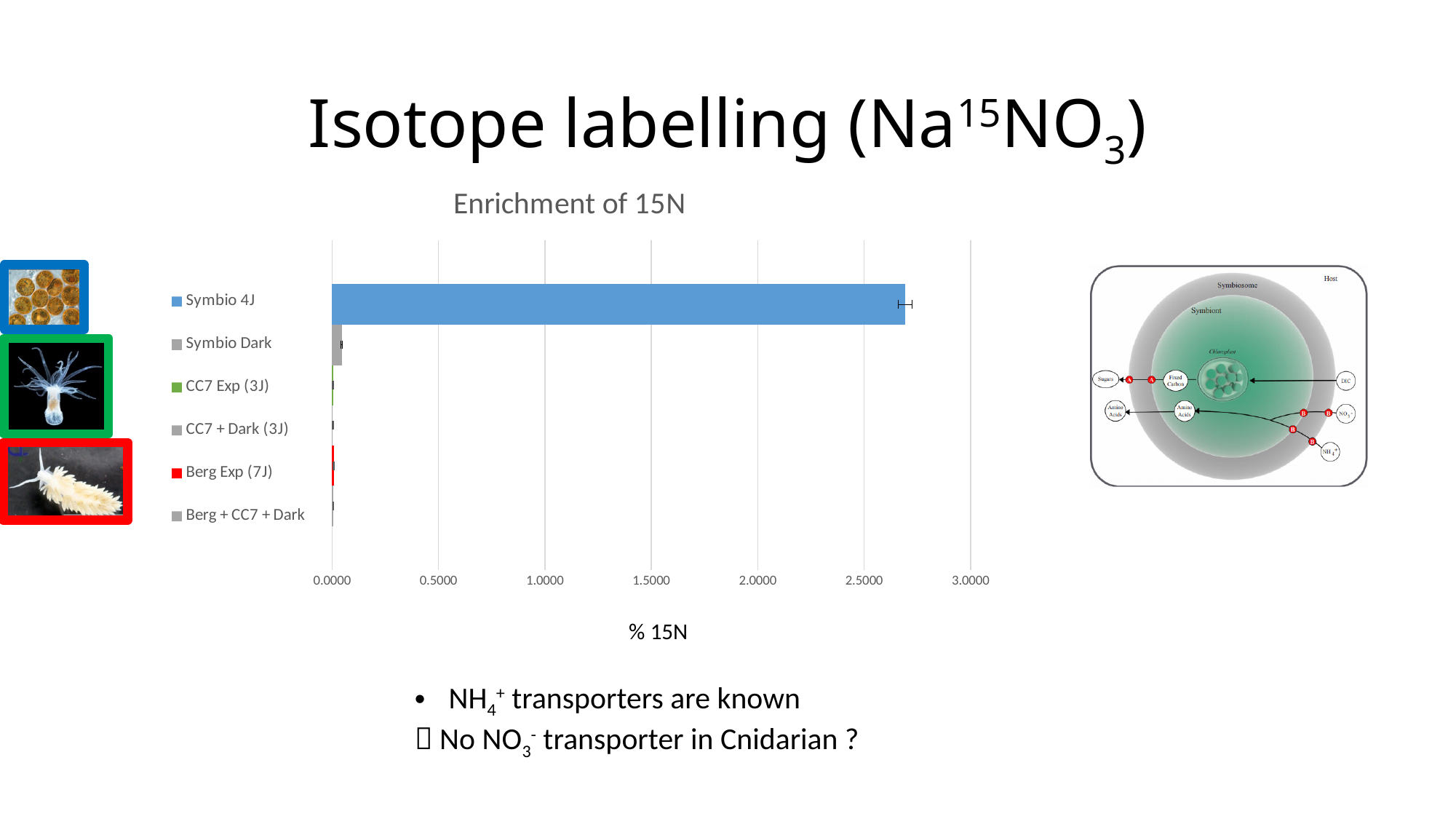
What is the title of the chart? Enrichment of 15N Is the value for Symbio 4J greater or less than 2.5000? greater Is the value for Symbio 4J greater or less than 3.0000? less Which is larger, the value for Symbio 4J or the value for Symbio Dark? Symbio 4J How many series does the chart legend list? 6 Which series has the highest enrichment of 15N? Symbio 4J What kind of chart is shown on the slide? bar chart Is the value for Symbio Dark greater or less than 0.5000? less What is the label of the x axis? % 15N Which is larger, the value for Symbio 4J or the value for Berg Exp (7J)? Symbio 4J